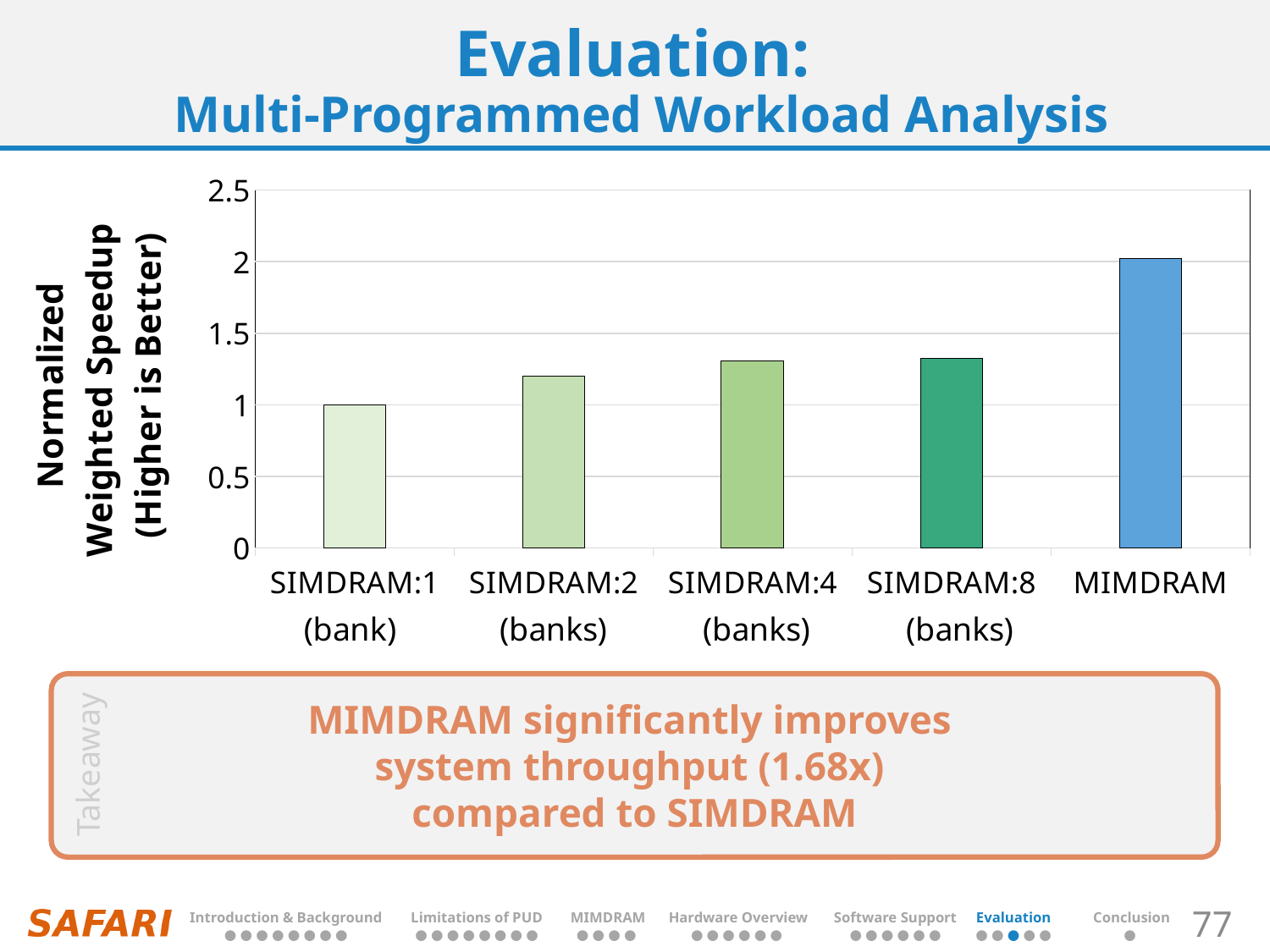
What is the normalized weighted speedup for SIMDRAM:1 (bank)? 1 Is the value for SIMDRAM:2 (banks) greater or less than 1.5? less Which category has the lowest normalized weighted speedup? SIMDRAM:1 (bank) How many bars (categories) are plotted in the chart? 5 Which is larger, the value for SIMDRAM:2 (banks) or the value for SIMDRAM:1 (bank)? SIMDRAM:2 (banks) Is the value for SIMDRAM:8 (banks) greater or less than 1? greater Is the value for MIMDRAM greater or less than 1.5? greater What kind of chart is shown on the slide? bar chart Do the bar values rise or fall from left to right across the x axis? rise Which category has the highest normalized weighted speedup? MIMDRAM Which is larger, the value for MIMDRAM or the value for SIMDRAM:8 (banks)? MIMDRAM What is the label of the y axis? Normalized Weighted Speedup (Higher is Better)